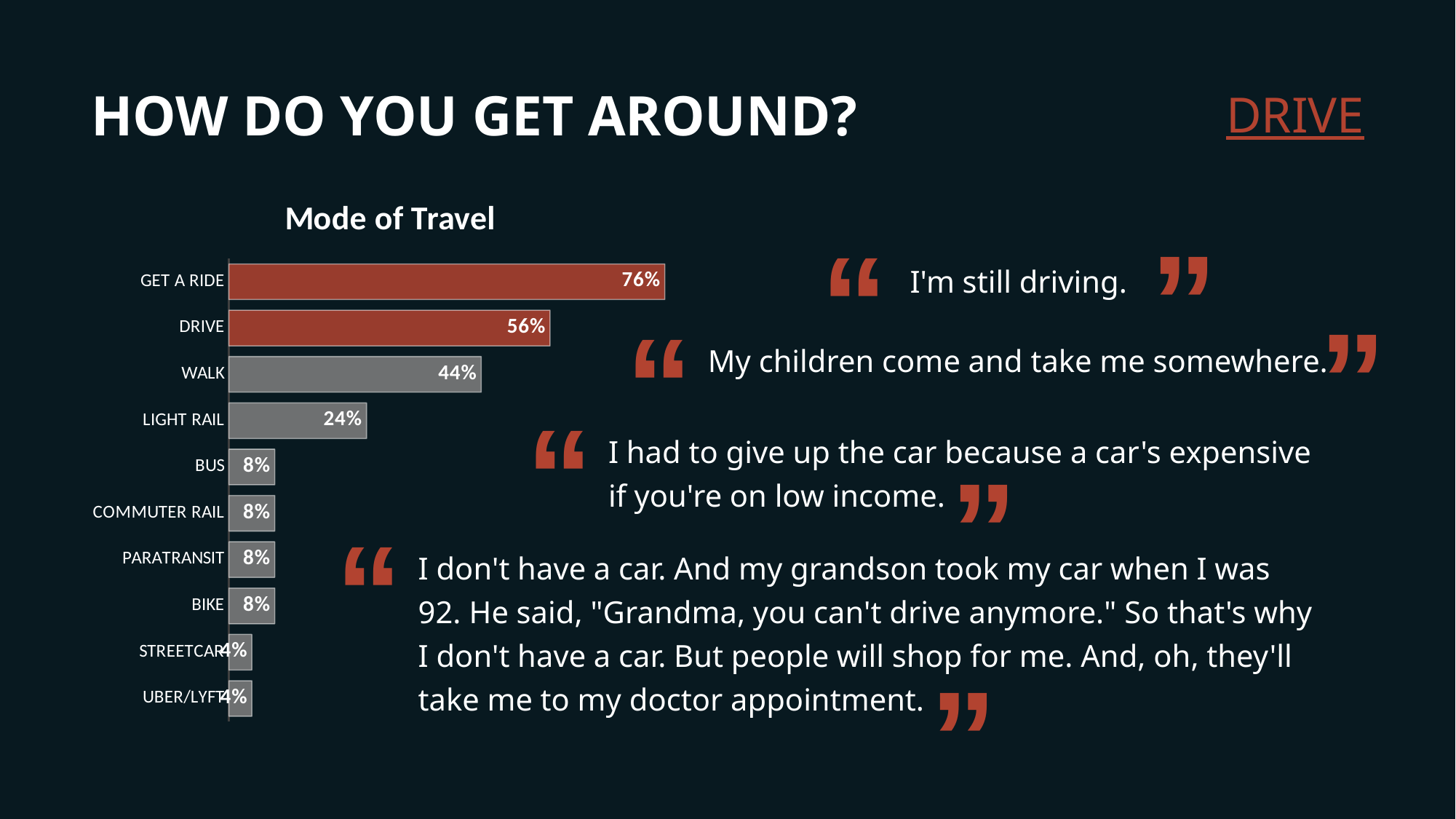
What kind of chart is the Mode of Travel chart? Bar chart Which is larger, the value for DRIVE or the value for WALK? DRIVE What is the value for WALK in the Mode of Travel chart? 44% What is the value for GET A RIDE in the Mode of Travel chart? 76% What is the difference between the values for WALK and LIGHT RAIL? 20% What is the value for DRIVE in the Mode of Travel chart? 56% What is the value for LIGHT RAIL in the Mode of Travel chart? 24% How many categories are shown in the Mode of Travel chart? 10 What is the title of the chart on the slide? Mode of Travel Which mode of travel has the highest value in the chart? GET A RIDE What is the difference between the values for GET A RIDE and DRIVE? 20% Which two bars in the Mode of Travel chart are coloured red rather than grey? GET A RIDE and DRIVE